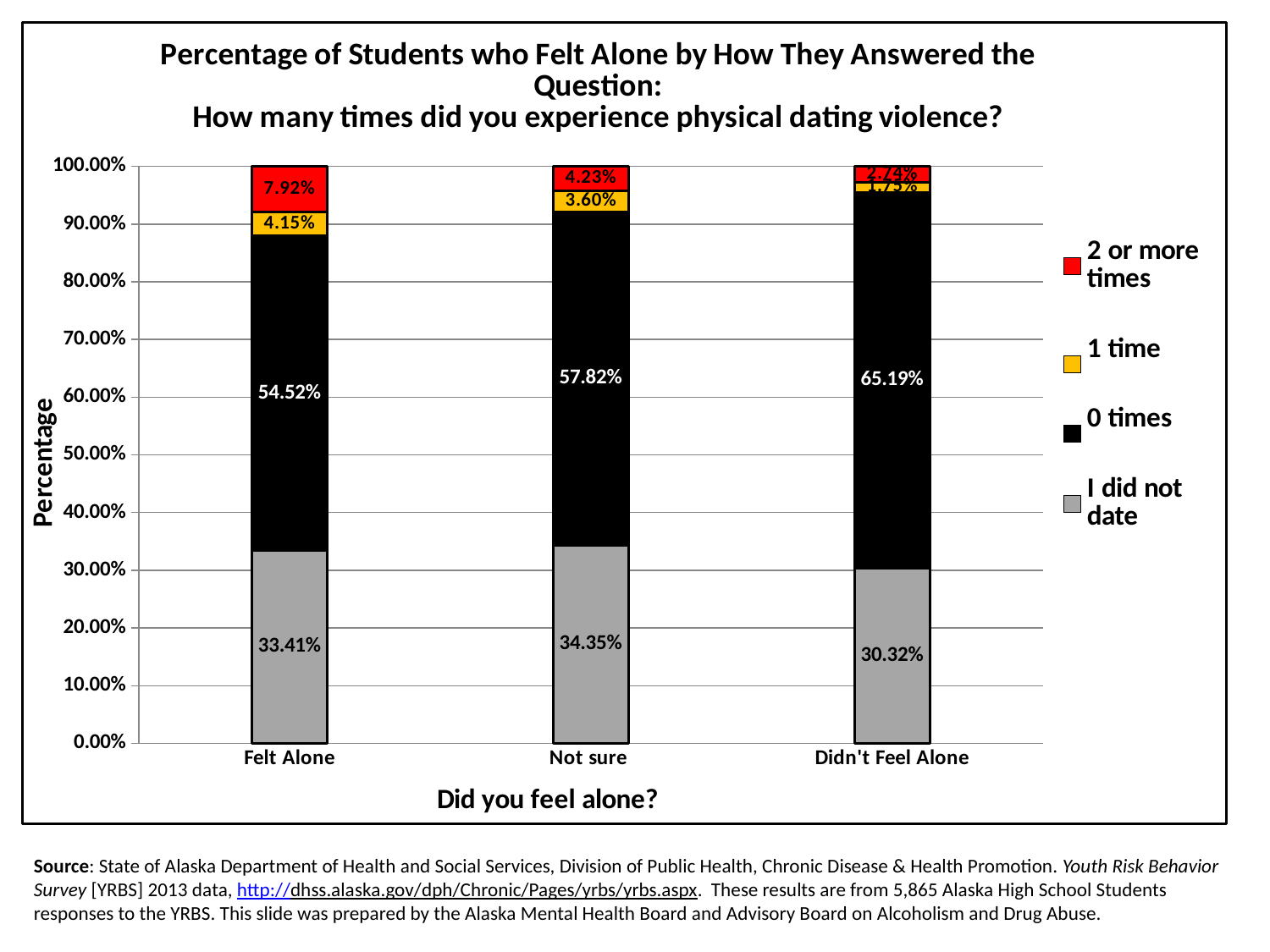
What percentage of students who Didn't Feel Alone answered I did not date? 30.32% What colour represents the 1 time series? Yellow Which response category has the lowest percentage for I did not date? Didn't Feel Alone How many series does the legend list? 4 What percentage of students who were Not sure answered 1 time? 3.60% Is the 2 or more times percentage larger for Felt Alone or for Not sure? Felt Alone What percentage of students who Felt Alone answered 2 or more times? 7.92% Which response category has the highest percentage for 0 times? Didn't Feel Alone What kind of chart is shown on the slide? Stacked bar chart What percentage of students who Felt Alone answered 0 times? 54.52% What is the difference between the 0 times percentage for Didn't Feel Alone and for Felt Alone? 10.67% How many response categories are shown on the x axis? 3